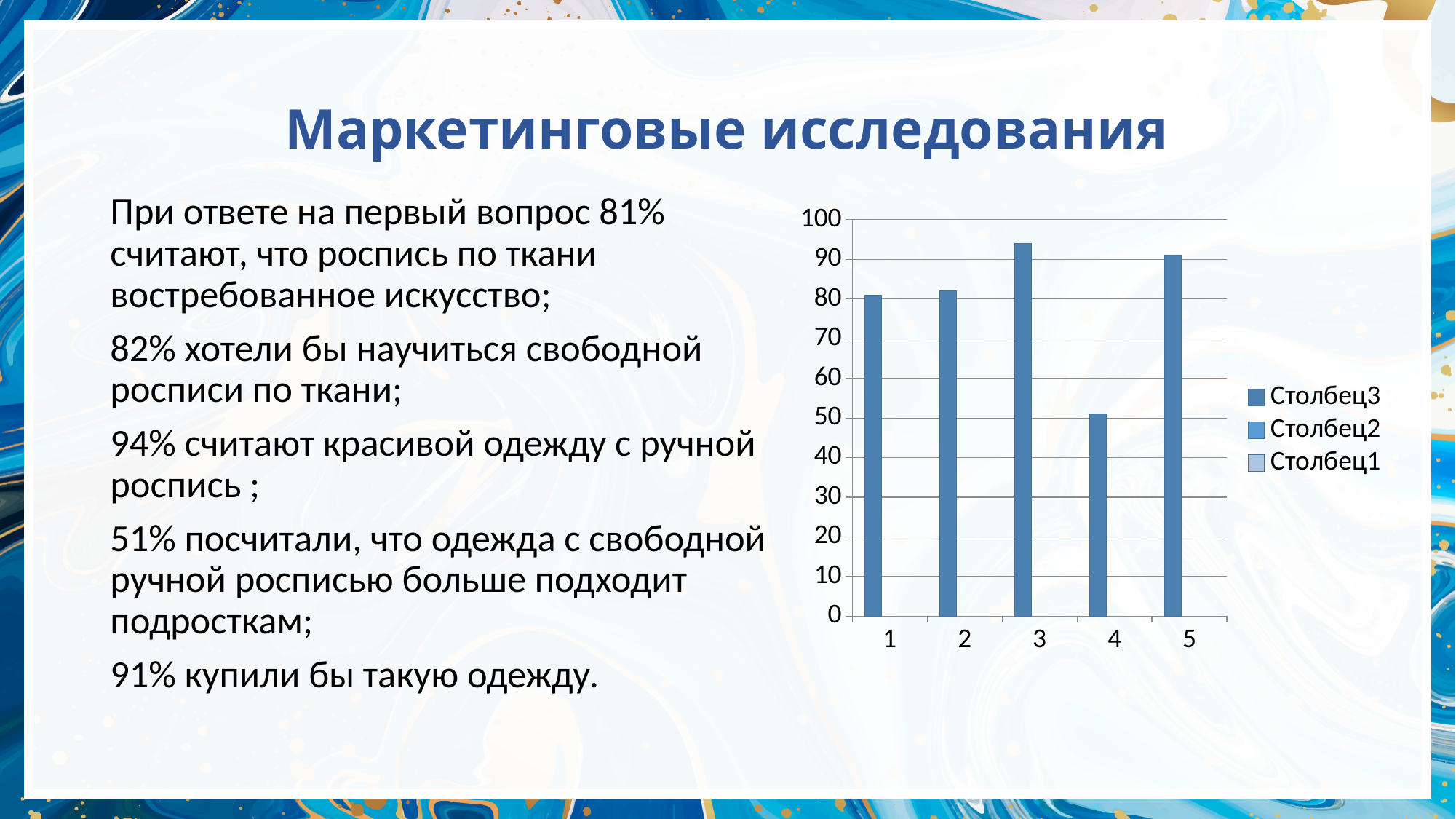
What kind of chart is shown on the slide? bar chart Is the value for category 3 greater or less than 90? greater What is the first entry listed in the chart legend? Столбец3 Which category has the shortest bar in the chart? 4 Which is larger, the value for category 3 or the value for category 4? category 3 Is the value for category 4 greater or less than 60? less Is the value for category 5 greater or less than 80? greater How many categories are shown on the x axis of the chart? 5 How many series does the chart legend list? 3 Which category has the tallest bar in the chart? 3 Which is larger, the value for category 5 or the value for category 1? category 5